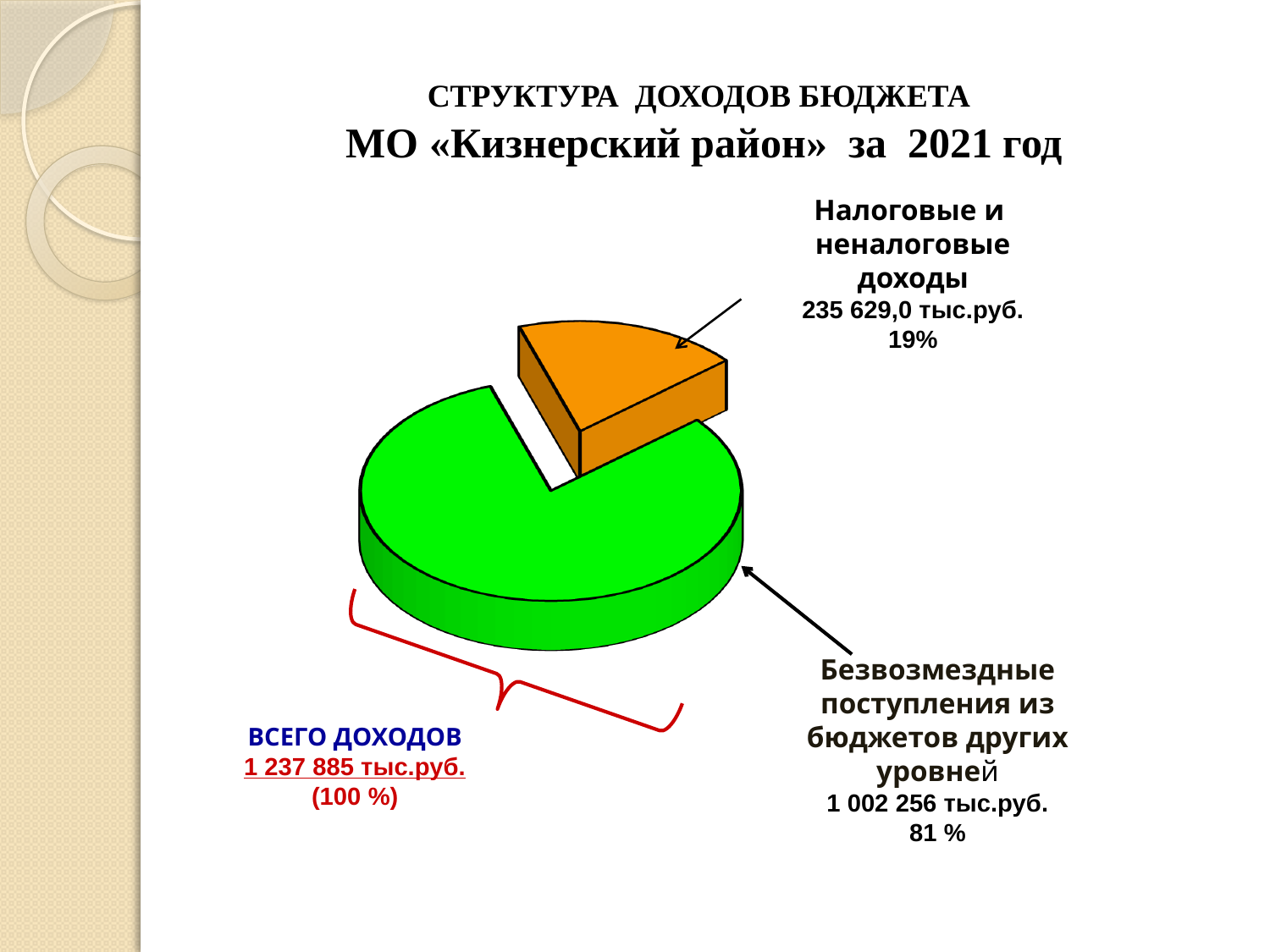
Which slice of the pie is the largest? Безвозмездные поступления из бюджетов других уровней What share of the pie is «Безвозмездные поступления из бюджетов других уровней»? 81 % What is the value for «Безвозмездные поступления из бюджетов других уровней»? 1 002 256 тыс.руб. What is the total of all incomes (ВСЕГО ДОХОДОВ) shown on the slide? 1 237 885 тыс.руб. What kind of chart is shown on the slide? pie chart What is the value for «Налоговые и неналоговые доходы»? 235 629,0 тыс.руб. How many slices does the pie chart have? 2 What share of the pie is «Налоговые и неналоговые доходы»? 19% What colour is the slice for «Налоговые и неналоговые доходы»? orange What is the difference between «Безвозмездные поступления из бюджетов других уровней» and «Налоговые и неналоговые доходы»? 766 627 тыс.руб. Which is larger: «Налоговые и неналоговые доходы» or «Безвозмездные поступления из бюджетов других уровней»? Безвозмездные поступления из бюджетов других уровней Which slice of the pie is the smallest? Налоговые и неналоговые доходы